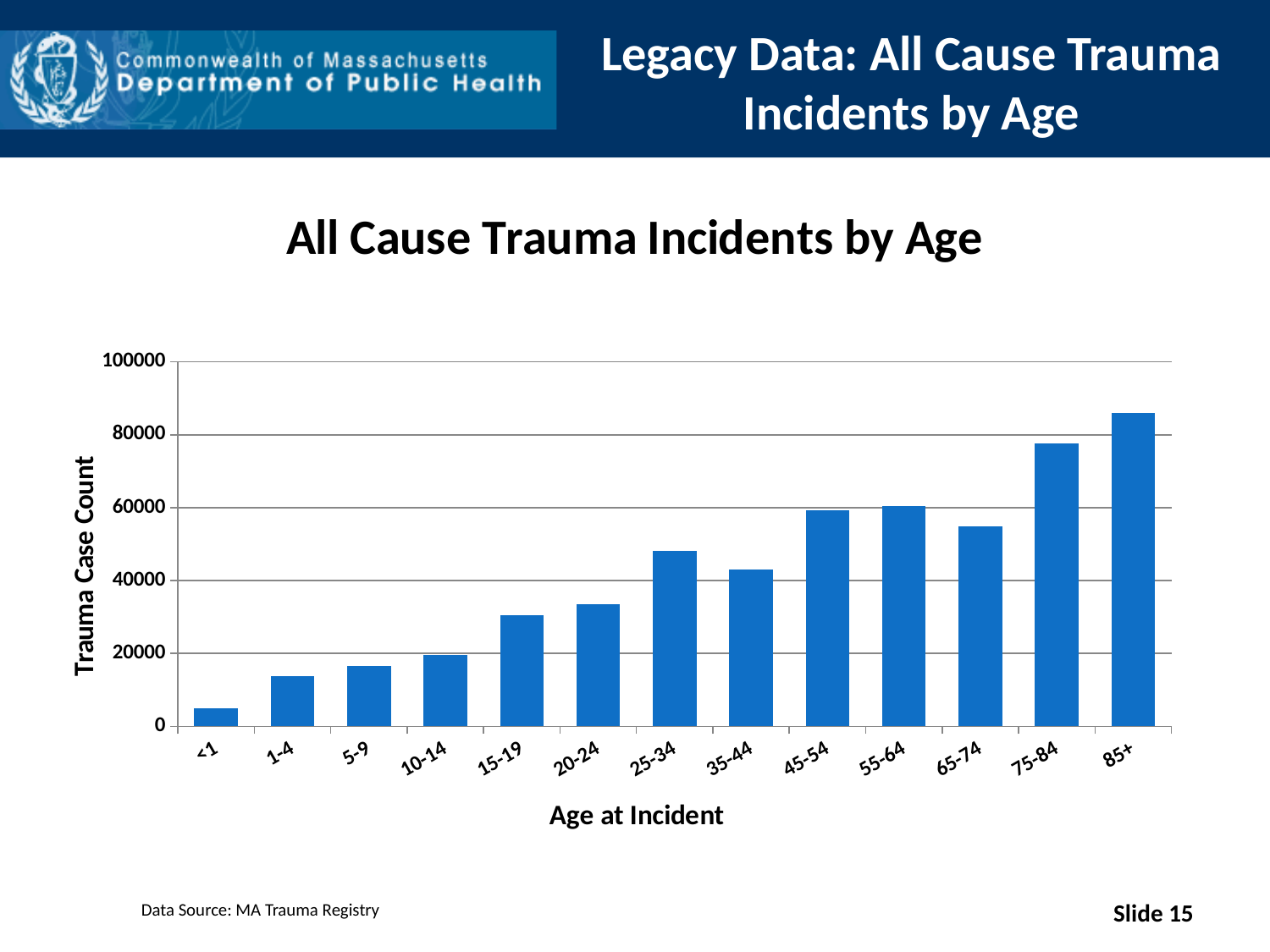
What kind of chart is shown on the slide? Bar chart Which age group has a higher trauma case count, 65-74 or 75-84? 75-84 Is the trauma case count for the 85+ age group greater or less than 80000? greater Is the trauma case count for the 20-24 age group greater or less than 40000? less What is the label of the y axis? Trauma Case Count Which age group has a higher trauma case count, 25-34 or 35-44? 25-34 Which age group has the highest trauma case count? 85+ Is the trauma case count for the 15-19 age group greater or less than 20000? greater How many age groups are shown on the x axis? 13 Which age group has the lowest trauma case count? <1